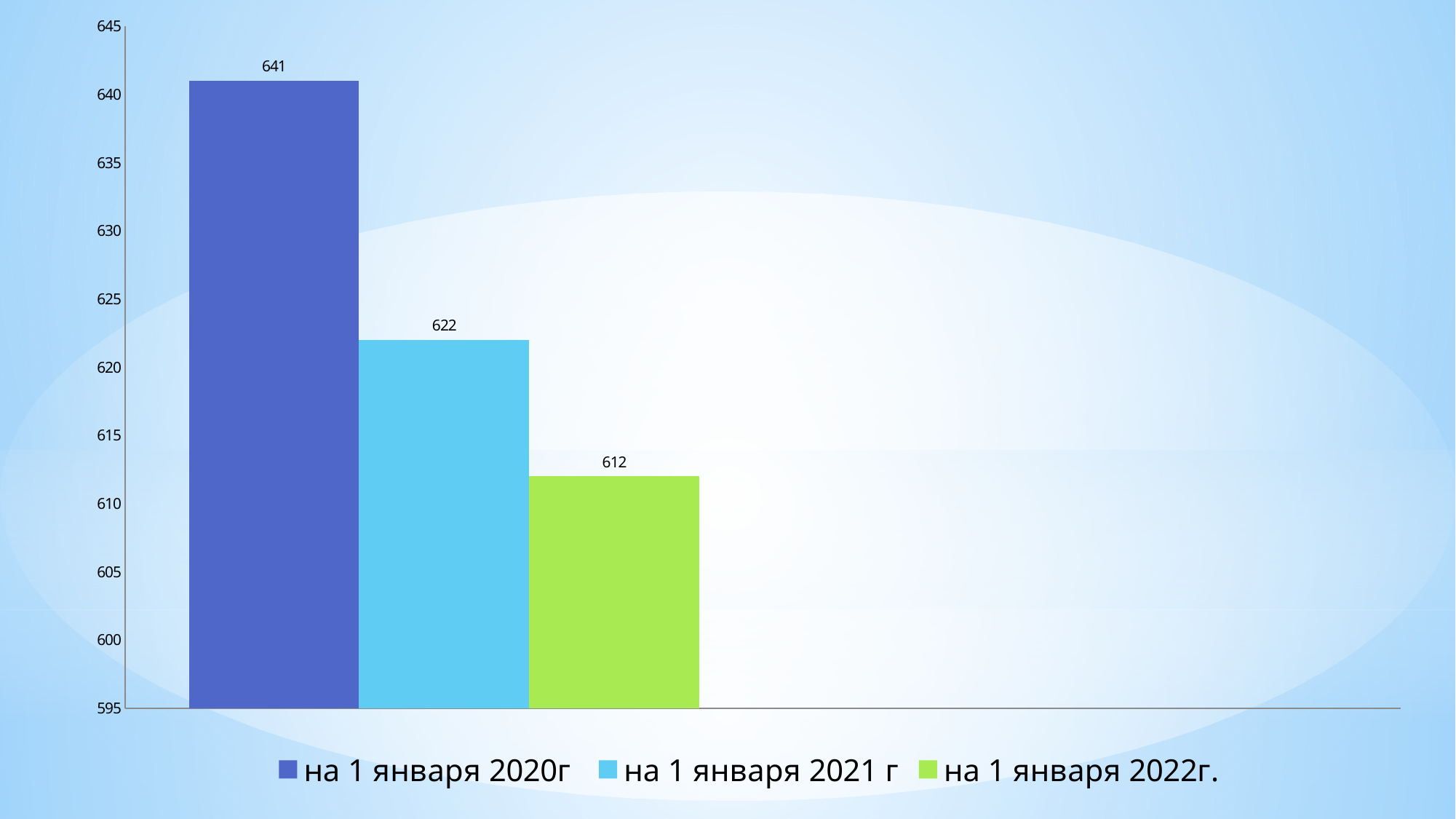
What is the value for на 1 января 2020г? 641 What is the value for на 1 января 2022г.? 612 Is the value for на 1 января 2021 г greater or less than 620? greater What is the difference between the values for на 1 января 2021 г and на 1 января 2022г.? 10 Do the values rise or fall from 2020 to 2022? fall How many series does the legend list? 3 What is the difference between the values for на 1 января 2020г and на 1 января 2022г.? 29 Which series has the highest value? на 1 января 2020г Which series has the lowest value? на 1 января 2022г. What is the value for на 1 января 2021 г? 622 Which is larger, the value for на 1 января 2020г or на 1 января 2021 г? на 1 января 2020г What kind of chart is shown on the slide? bar chart